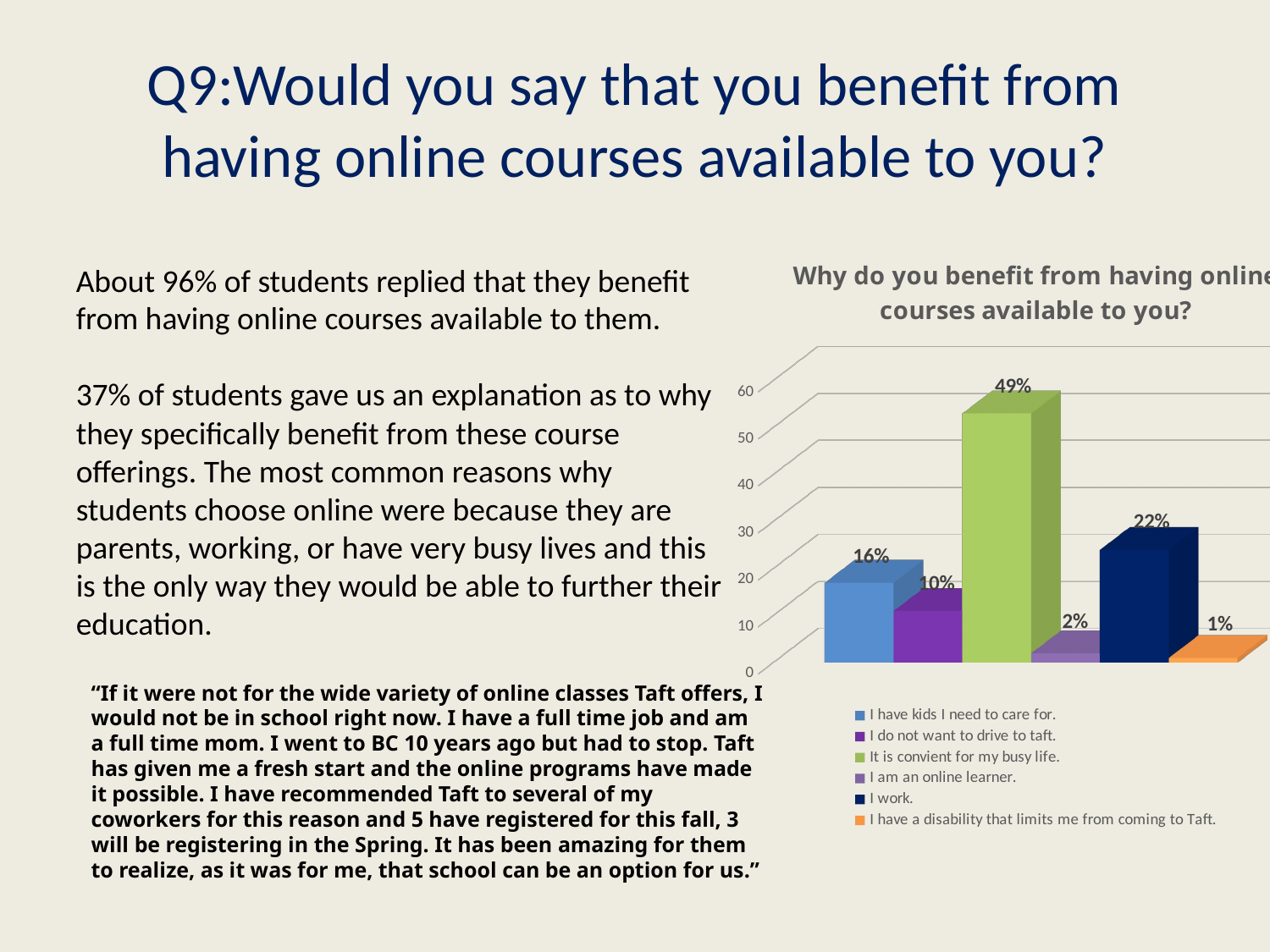
Which reason has the lowest percentage in the chart? I have a disability that limits me from coming to Taft. How many bars are plotted in the chart? 6 What type of chart is shown on the slide? Bar chart What percentage of students said they benefit from online courses because it is convenient for their busy life? 49% What percentage of students gave "I work" as the reason they benefit from online courses? 22% Is the value for "I work" greater or less than 30? less How many entries does the chart legend list? 6 What percentage of students said "I do not want to drive to taft"? 10% Which reason has the highest percentage in the chart? It is convient for my busy life. What is the difference in percentage points between "It is convient for my busy life" and "I work"? 27 Which is larger: the percentage for "I have kids I need to care for" or for "I do not want to drive to taft"? I have kids I need to care for. What percentage of students said "I have kids I need to care for"? 16%